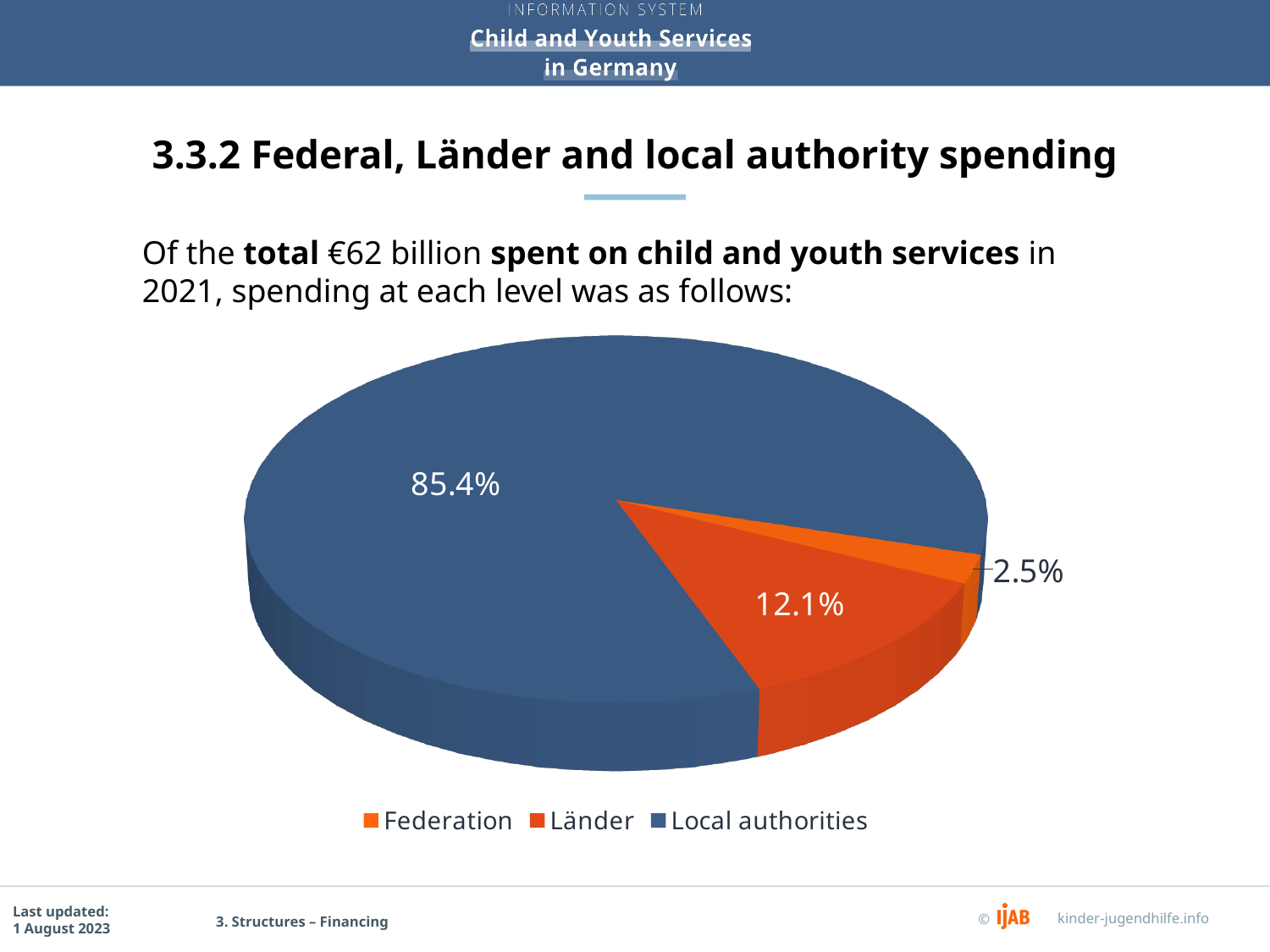
What colour is the Local authorities slice? Blue Which level has the largest share of spending? Local authorities What kind of chart is shown on the slide? Pie chart Which level has the smallest share of spending? Federation What share of spending is attributed to Länder? 12.1% What share of spending is attributed to Local authorities? 85.4% How many slices does the pie chart have? 3 How many entries does the legend list? 3 What is the difference in percentage points between the Local authorities share and the Länder share? 73.3 What is the difference in percentage points between the Länder share and the Federation share? 9.6 Which has a larger share, Länder or Federation? Länder What share of spending is attributed to the Federation? 2.5%